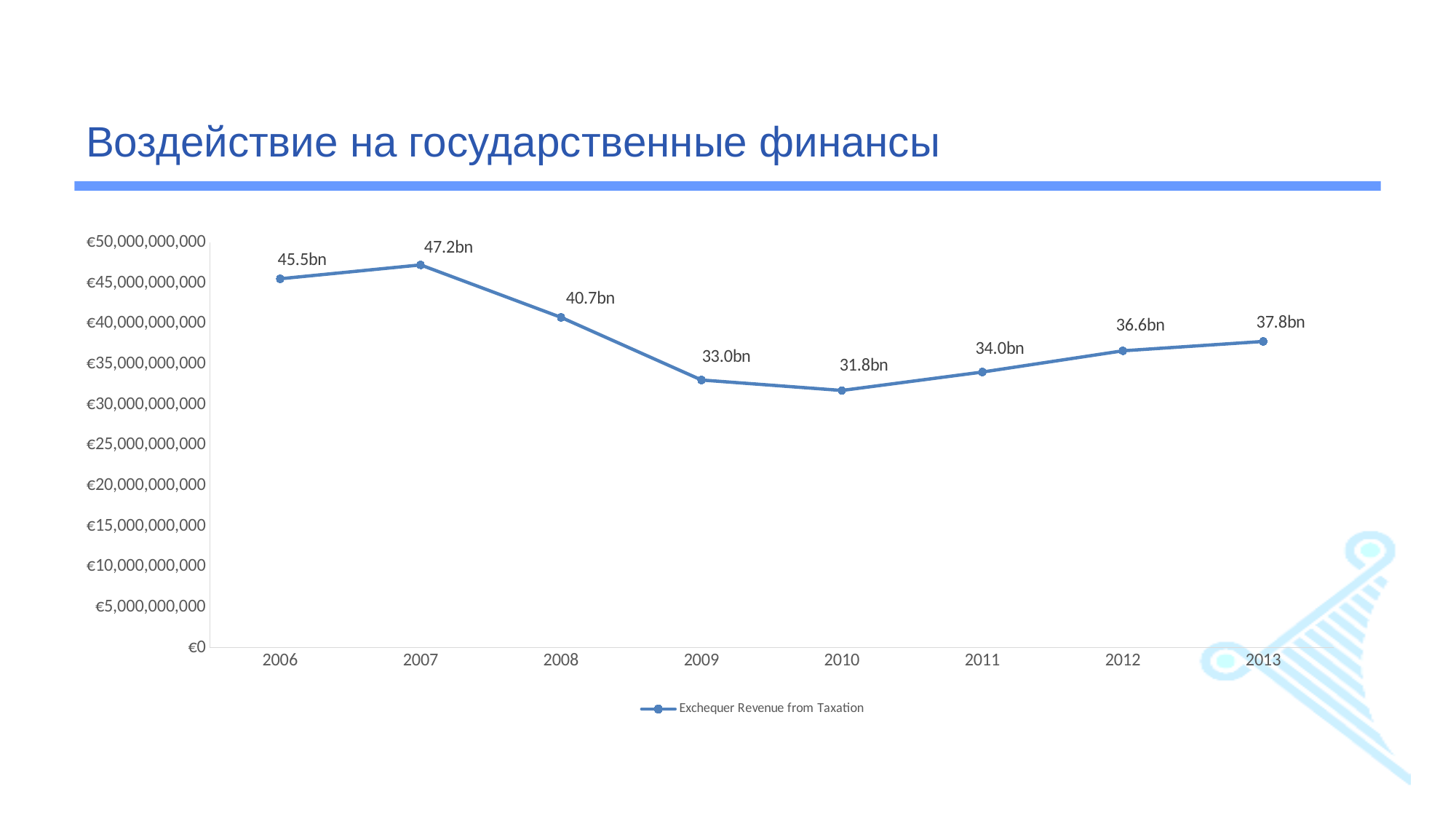
Which year has a higher Exchequer Revenue from Taxation, 2006 or 2008? 2006 What kind of chart is shown on the slide? line chart Is the Exchequer Revenue from Taxation in 2009 greater or less than €35,000,000,000? less What is the difference between the Exchequer Revenue from Taxation in 2007 and in 2010? 15.4bn Which year has the highest Exchequer Revenue from Taxation? 2007 How many series does the legend list? 1 What is the Exchequer Revenue from Taxation in 2013? 37.8bn How many years are plotted on the chart? 8 What is the Exchequer Revenue from Taxation in 2010? 31.8bn Which year has the lowest Exchequer Revenue from Taxation? 2010 What is the Exchequer Revenue from Taxation in 2007? 47.2bn Does the Exchequer Revenue from Taxation rise or fall from 2010 to 2013? rise